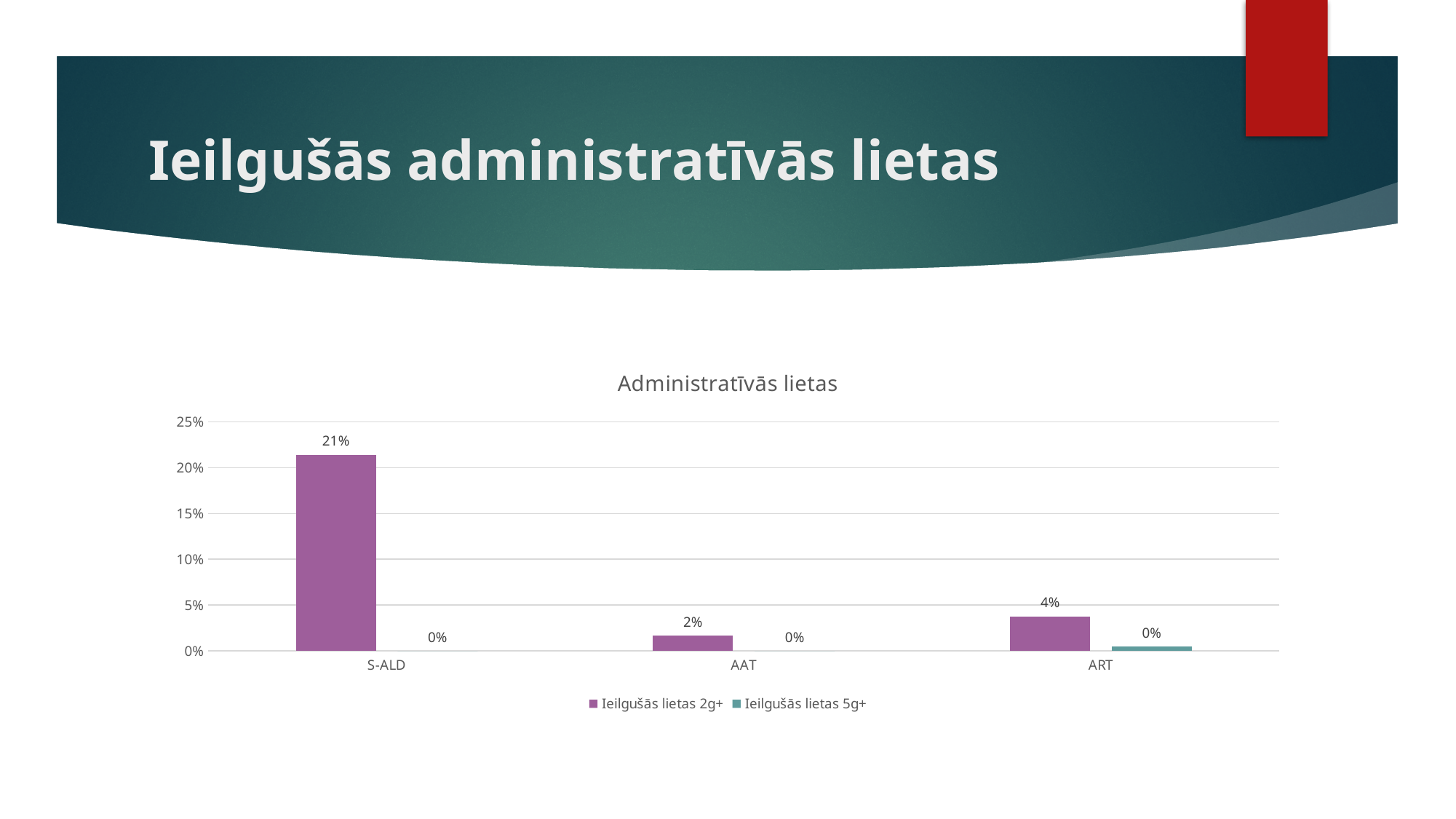
Which is larger in the Ieilgušās lietas 2g+ series: AAT or ART? ART What is the value for AAT in the Ieilgušās lietas 2g+ series? 2% How many series does the legend list? 2 Which category has the lowest value in the Ieilgušās lietas 2g+ series? AAT What is the value for ART in the Ieilgušās lietas 5g+ series? 0% Which category has the highest value in the Ieilgušās lietas 2g+ series? S-ALD What kind of chart is shown on the slide? bar chart Is the Ieilgušās lietas 2g+ value for S-ALD greater or less than 20%? greater What is the value for S-ALD in the Ieilgušās lietas 2g+ series? 21% What is the difference between the Ieilgušās lietas 2g+ values for S-ALD and ART? 17% How many categories are shown on the x axis? 3 What is the value for ART in the Ieilgušās lietas 2g+ series? 4%